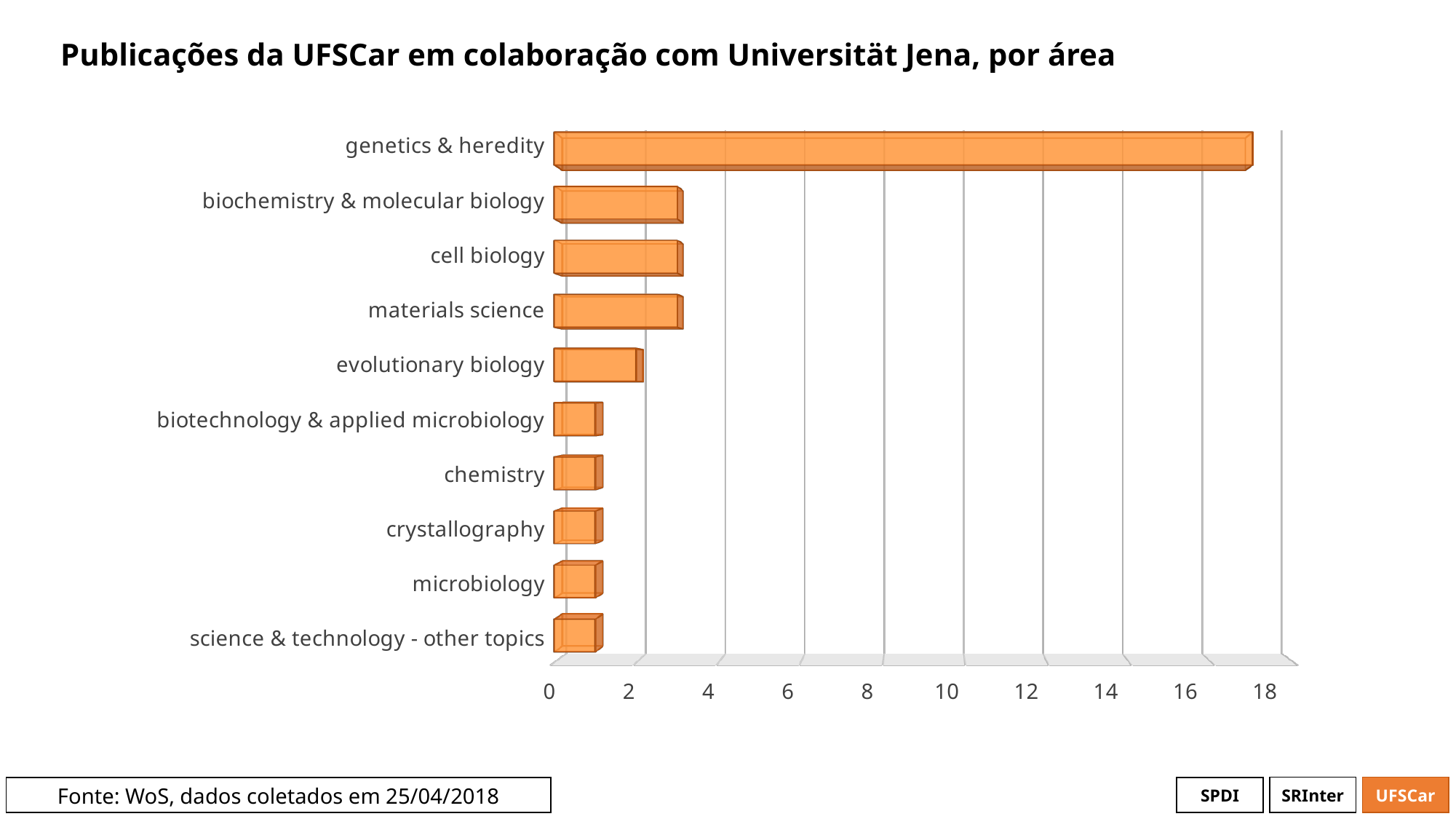
Is the value for chemistry greater or less than 2? less Do the bar values increase or decrease from the top of the chart to the bottom? decrease How many areas (categories) are shown in the chart? 10 What kind of chart is shown on the slide? bar chart Is the value for materials science greater or less than 2? greater Is the value for genetics & heredity greater or less than 18? less What is the title of the chart? Publicações da UFSCar em colaboração com Universität Jena, por área Which area has the highest number of publications? genetics & heredity Which has more publications, genetics & heredity or cell biology? genetics & heredity Which has more publications, evolutionary biology or crystallography? evolutionary biology